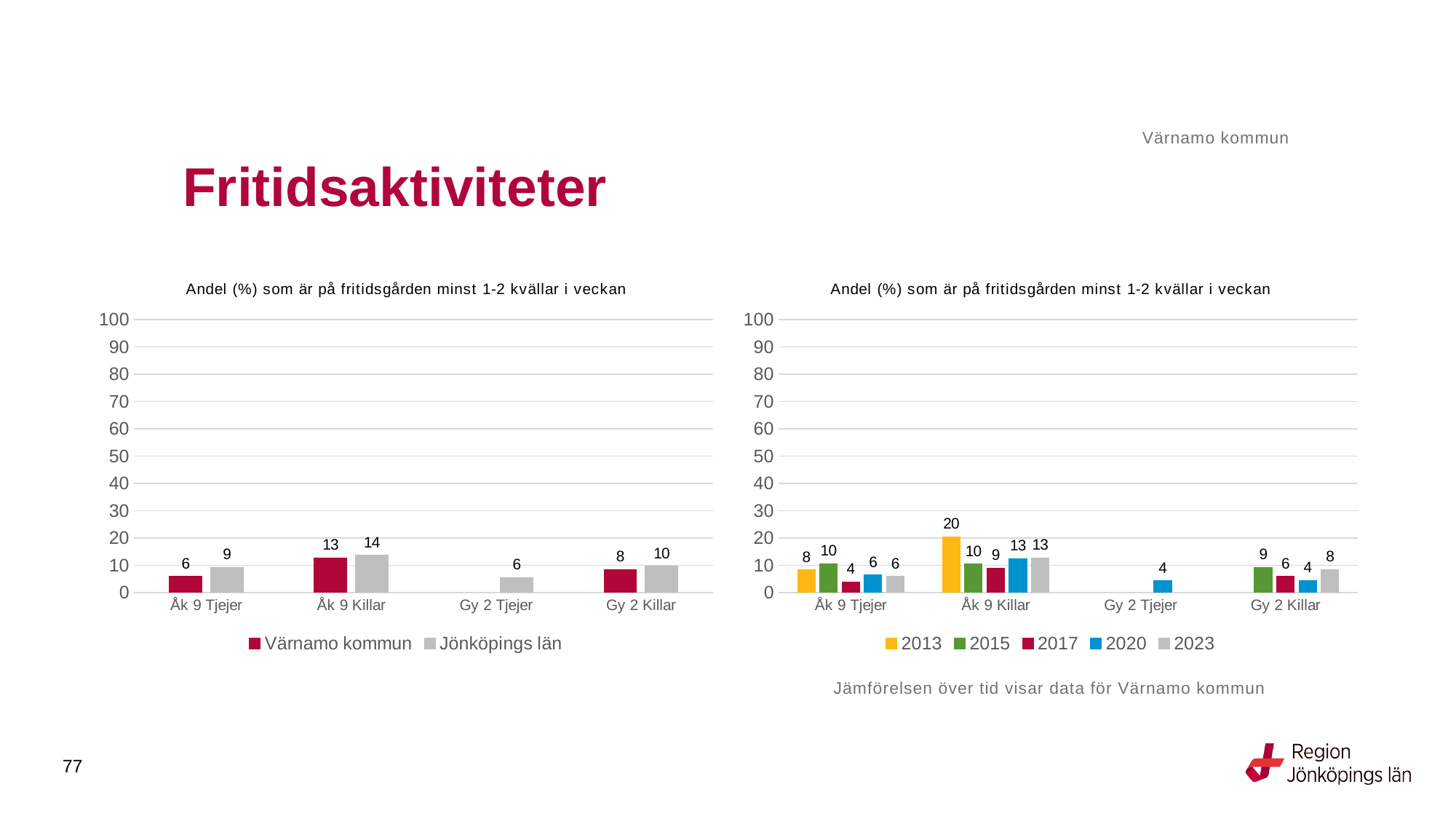
In the right chart, what is the value for 2017 for Åk 9 Tjejer? 4 What kind of chart is the left chart? bar chart In the left chart, what is the value for Jönköpings län for Gy 2 Tjejer? 6 In the right chart, how many series does the legend list? 5 In the left chart, which category has the highest value for Jönköpings län? Åk 9 Killar In the right chart, is the value for 2015 for Gy 2 Killar larger or smaller than the value for 2023 for Gy 2 Killar? larger In the right chart, which year has the lowest value for Gy 2 Killar? 2020 In the left chart, what is the value for Värnamo kommun for Åk 9 Killar? 13 In the right chart, which year has the highest value for Åk 9 Killar? 2013 In the left chart, what is the difference between Jönköpings län and Värnamo kommun for Gy 2 Killar? 2 In the right chart, what is the value for 2013 for Åk 9 Killar? 20 In the left chart, how many series does the legend list? 2